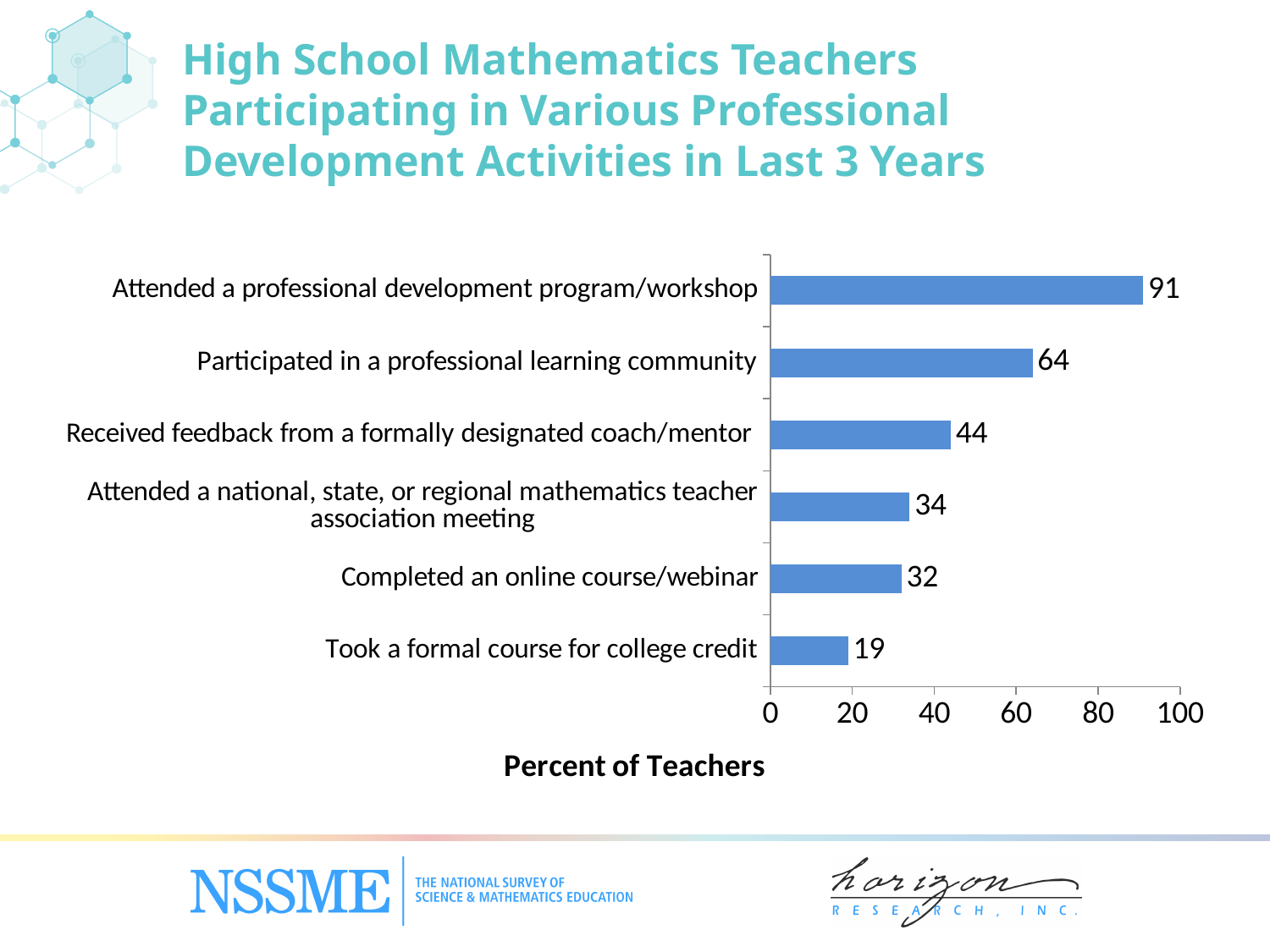
Which has a higher percent of teachers: attending a national, state, or regional mathematics teacher association meeting or completing an online course/webinar? Attended a national, state, or regional mathematics teacher association meeting What is the label of the horizontal axis? Percent of Teachers Which activity has the highest percent of teachers? Attended a professional development program/workshop What kind of chart is shown on the slide? Bar chart What percent of teachers took a formal course for college credit? 19 How many professional development activities are shown in the chart? 6 Which activity has the lowest percent of teachers? Took a formal course for college credit What percent of teachers received feedback from a formally designated coach/mentor? 44 What percent of teachers participated in a professional learning community? 64 What percent of high school mathematics teachers attended a professional development program/workshop? 91 What is the difference in percent of teachers between attending a professional development program/workshop and participating in a professional learning community? 27 What is the difference in percent of teachers between completing an online course/webinar and taking a formal course for college credit? 13